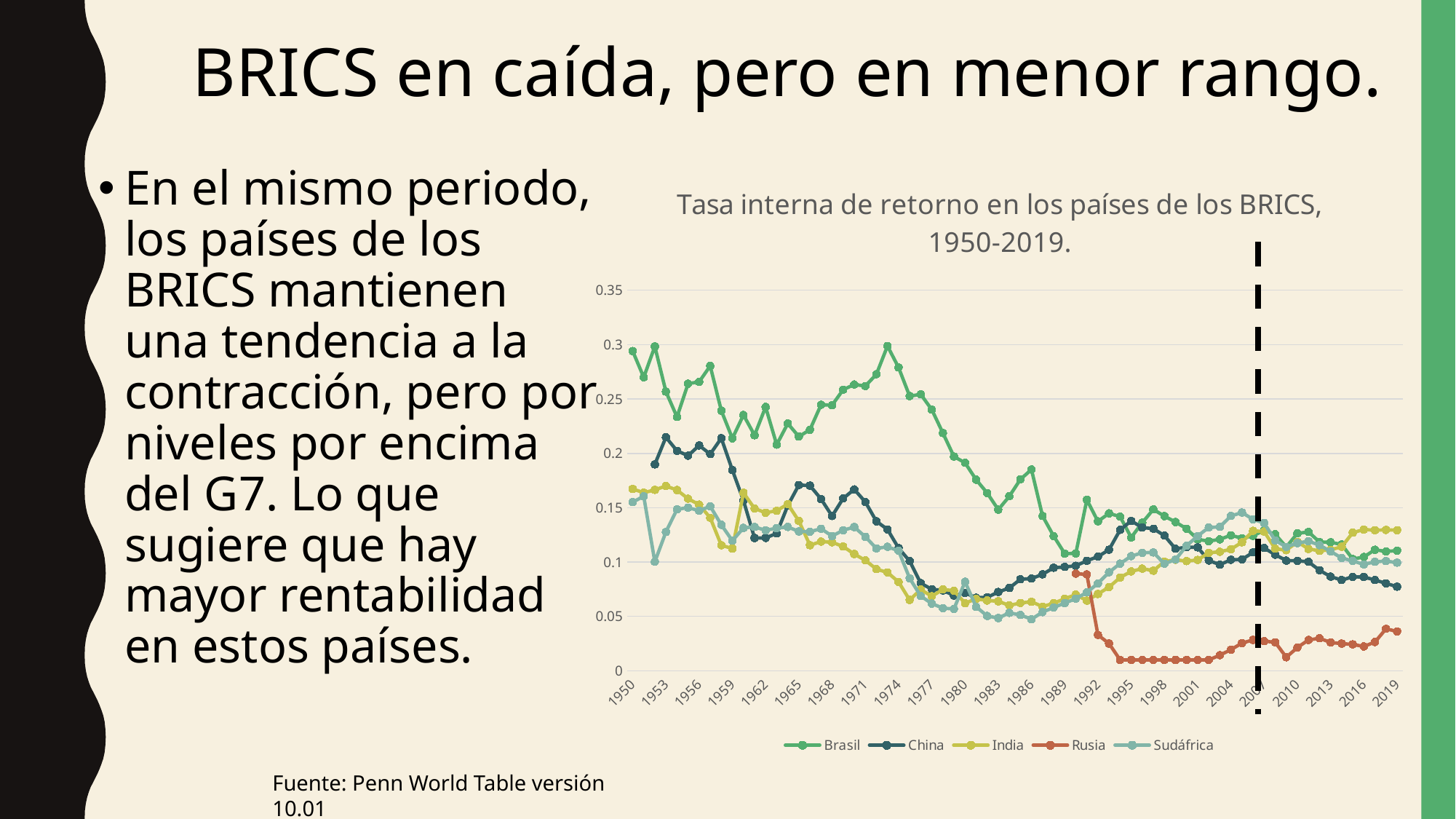
Is the value for China in 2019 greater or less than 0.1? less Which countries are listed in the chart's legend? Brasil, China, India, Rusia, Sudáfrica Which series has the lowest value in 2019? Rusia Is the value for Rusia in 1995 greater or less than 0.05? less What kind of chart is shown on the slide? Line chart How many series does the legend of the chart list? 5 Does the Brasil series generally rise or fall from 1950 to 2019? Fall Is the value for Brasil in 1974 greater or less than 0.25? greater Which series has the highest value in 1950? Brasil What is the title of the chart? Tasa interna de retorno en los países de los BRICS, 1950-2019.